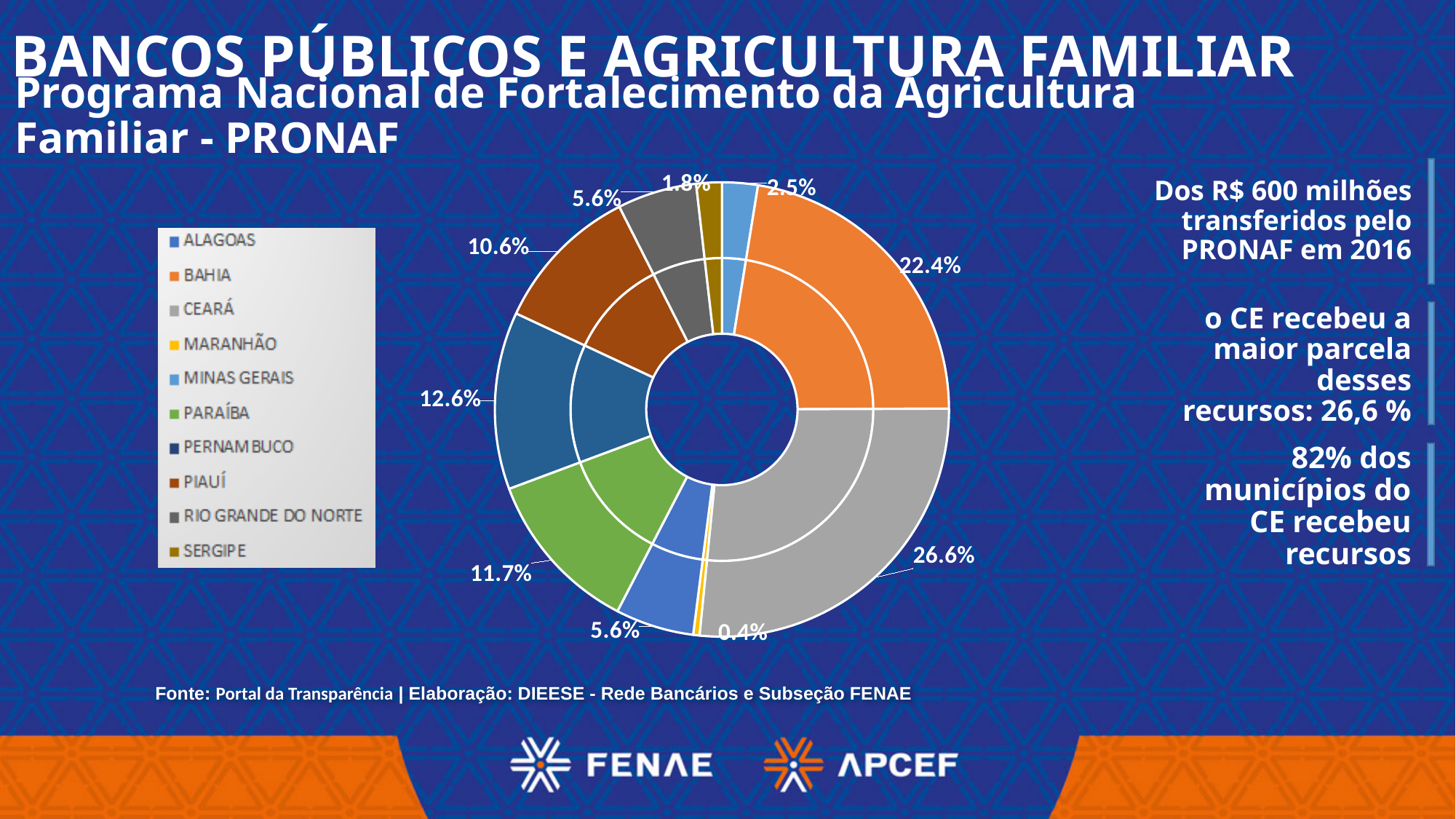
Which state received the largest share of the PRONAF transfers? Ceará Which state received the smallest share of the PRONAF transfers? Maranhão What kind of chart is shown on the slide? Doughnut chart What colour represents Bahia in the chart? Orange What is the difference in percentage points between the shares of Ceará and Bahia? 4.2 What share of the PRONAF transfers went to Pernambuco? 12.6% What share of the PRONAF transfers went to Bahia? 22.4% What share of the PRONAF transfers went to Piauí? 10.6% What share of the PRONAF transfers went to Ceará? 26.6% Which received a larger share of the PRONAF transfers, Paraíba or Pernambuco? Pernambuco What share of the PRONAF transfers went to Maranhão? 0.4% How many states are listed in the chart legend? 10